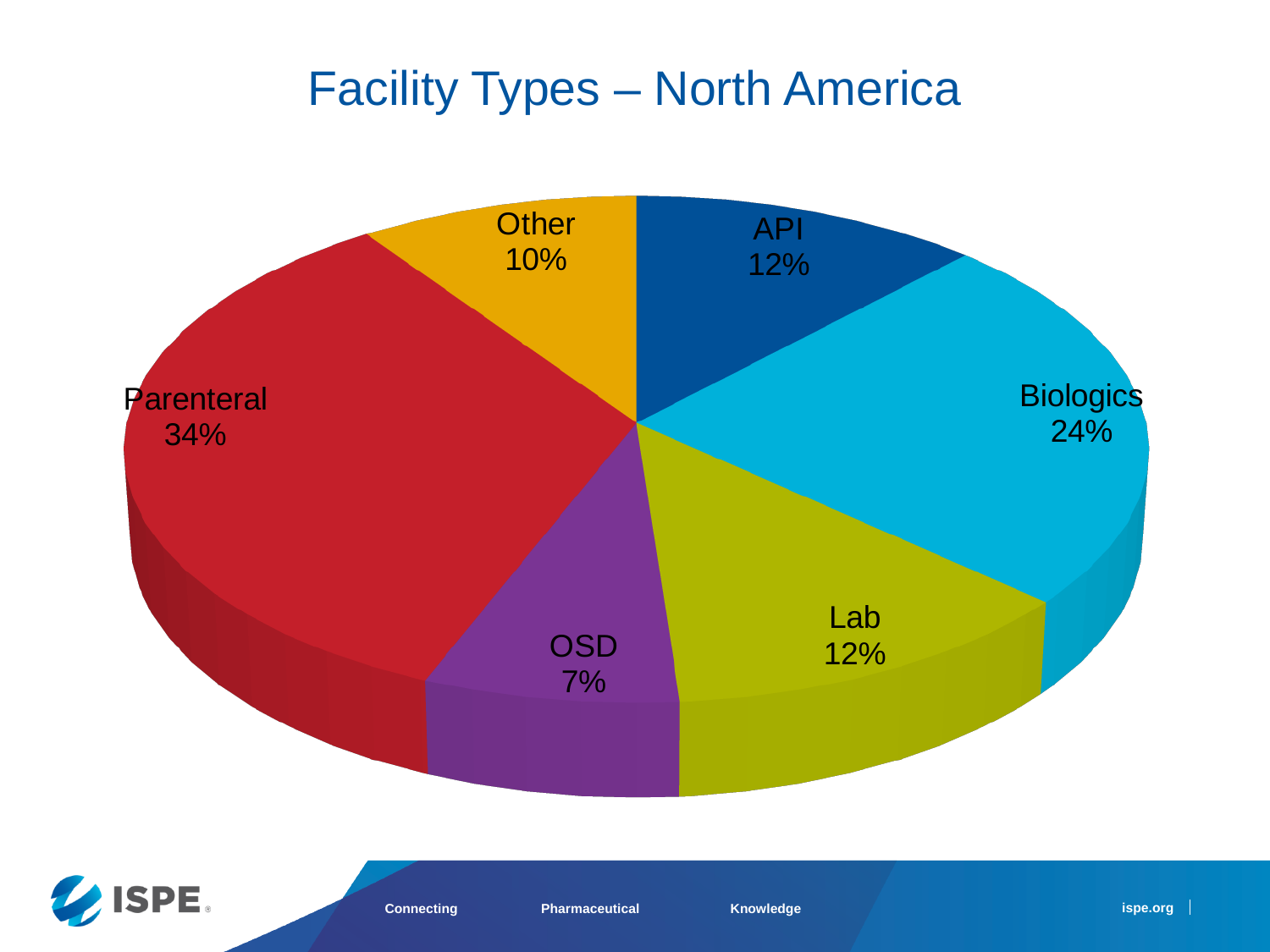
What share of the pie does Parenteral represent? 34% Which facility type has the largest share? Parenteral What percentage is shown for Other? 10% Which is larger, the share for Biologics or the share for API? Biologics What is the difference in percentage points between Other and OSD? 3 How many slices does the pie chart have? 6 What is the title of the chart? Facility Types – North America What is the difference in percentage points between Parenteral and Biologics? 10 What percentage is shown for OSD? 7% Which facility type has the smallest share? OSD What is the value shown for Biologics? 24% What kind of chart is shown on the slide? Pie chart